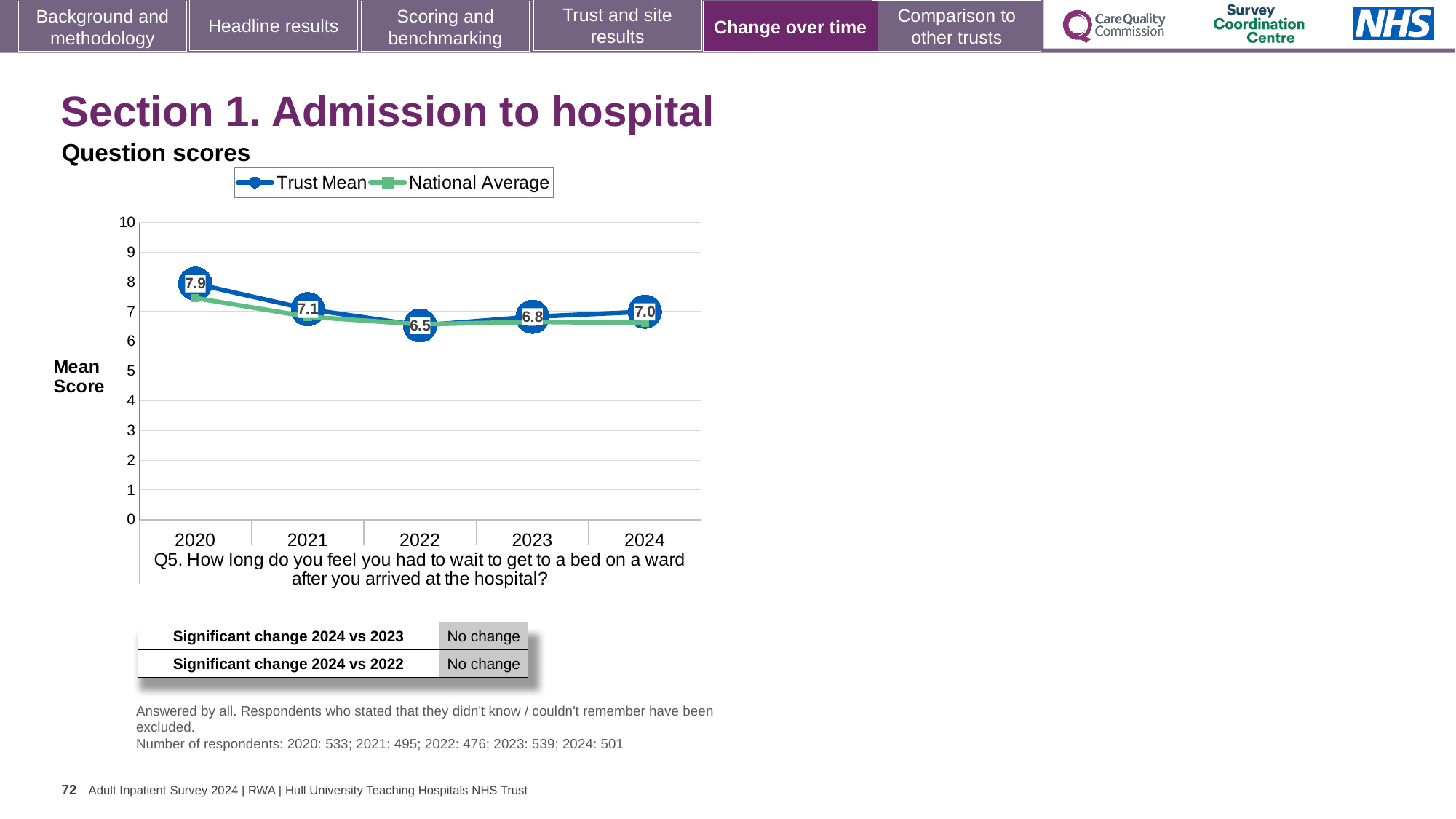
In which year is the Trust Mean score highest? 2020 What kind of chart is shown? Line chart What is the difference between the Trust Mean scores for 2020 and 2022? 1.4 Which is larger, the Trust Mean score for 2021 or for 2023? 2021 In which year is the Trust Mean score lowest? 2022 How many series does the legend list? 2 Is the National Average value for 2024 greater or less than 7? less What is the Trust Mean score for 2022? 6.5 Is the National Average value for 2020 greater or less than 7? greater How many years are plotted on the x axis? 5 What is the Trust Mean score for 2020? 7.9 What is the Trust Mean score for 2024? 7.0